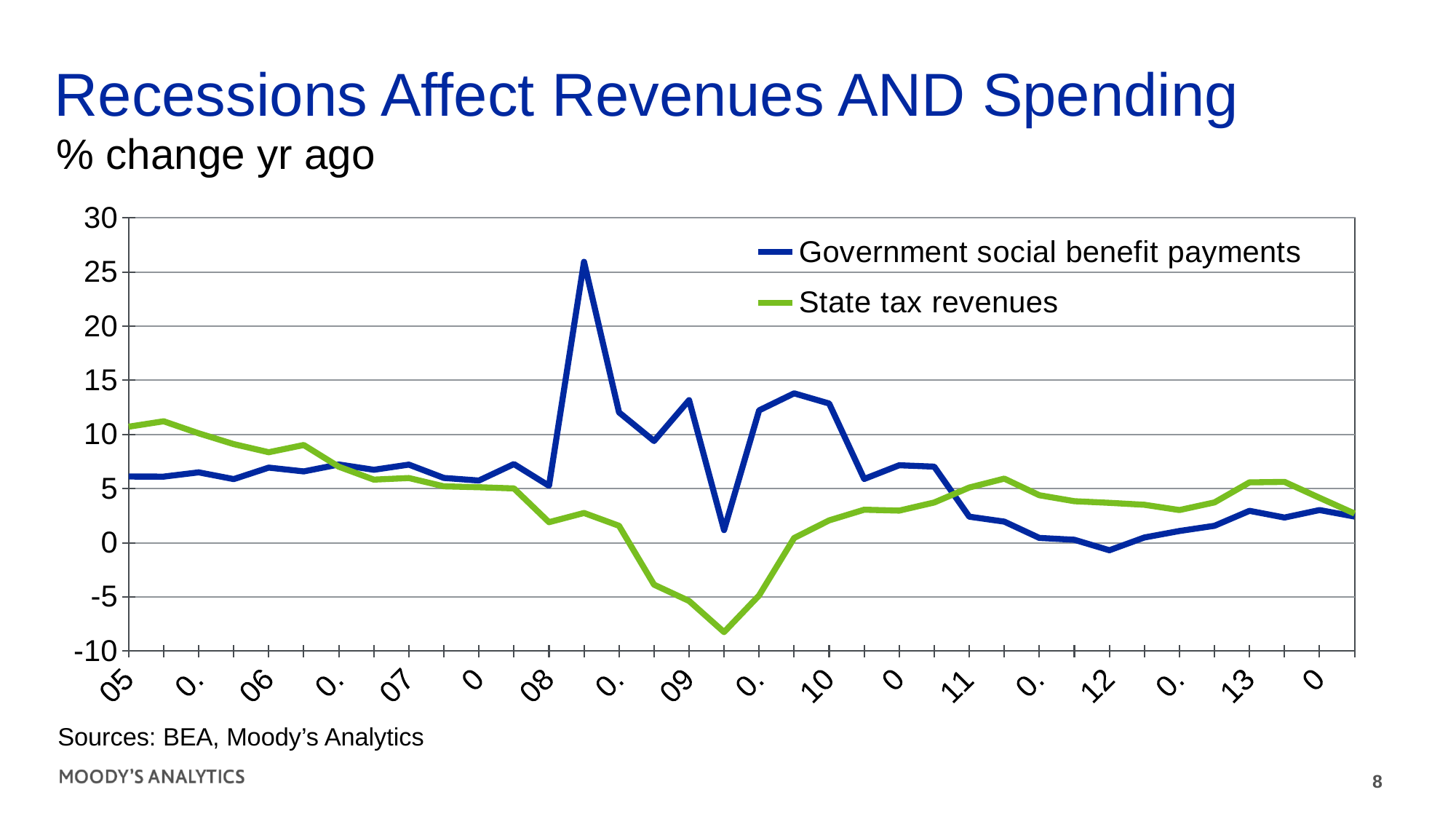
Do State tax revenues rise or fall between 05 and 09? fall At 05, which series has the higher value, Government social benefit payments or State tax revenues? State tax revenues Is the peak value of Government social benefit payments greater or less than 20? greater What are the two series named in the legend? Government social benefit payments; State tax revenues Which series reaches the lowest value on the chart? State tax revenues What is the title of the chart on the slide? Recessions Affect Revenues AND Spending Which series reaches the highest value on the chart? Government social benefit payments Is the value for Government social benefit payments at 05 greater or less than 10? less How many series does the legend list? 2 Is the lowest value of State tax revenues greater or less than -5? less Do State tax revenues rise or fall between 09 and 11? rise What kind of chart is shown on the slide? line chart